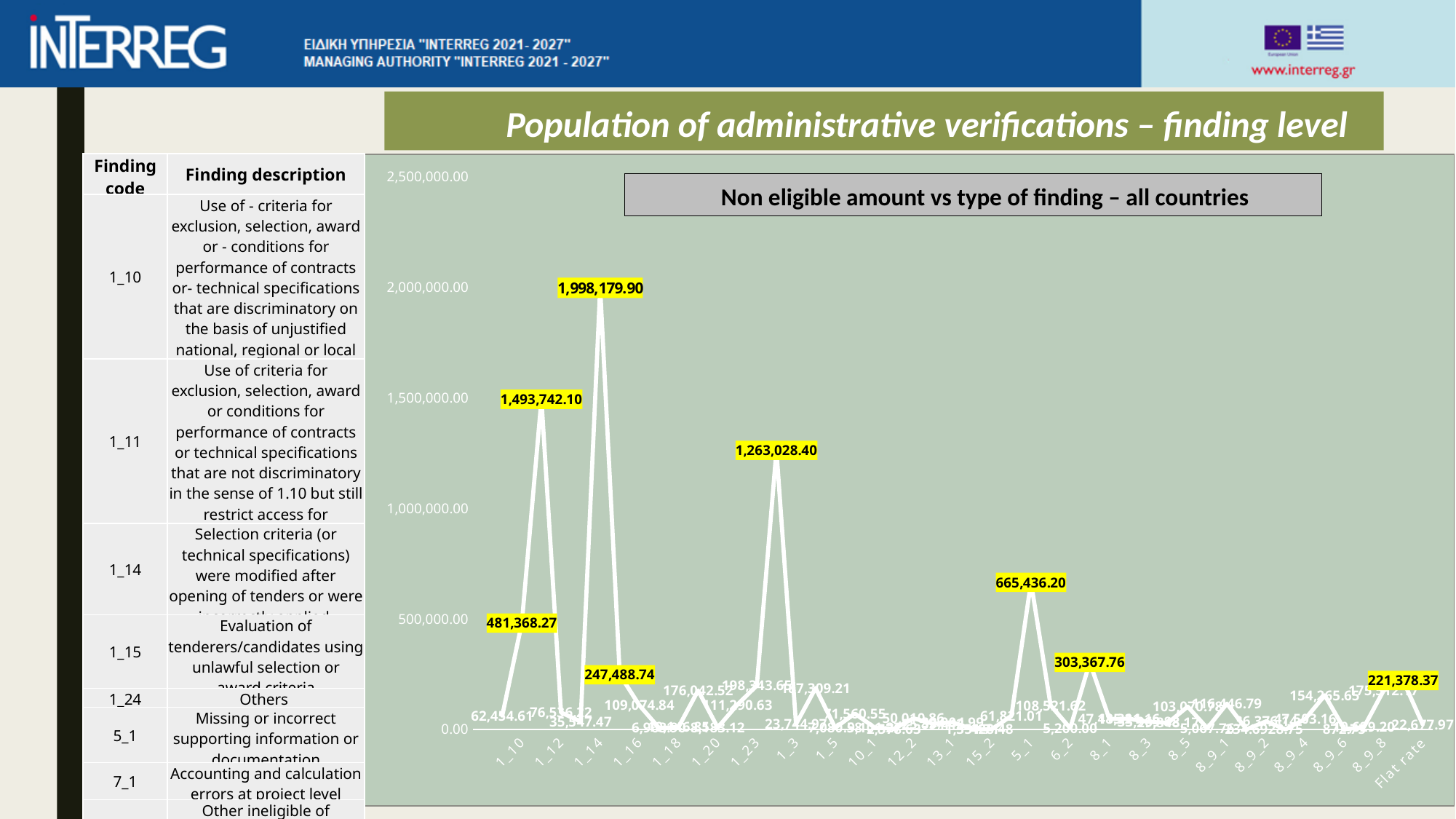
Which is larger, the highlighted value 665,436.20 or the highlighted value 303,367.76? 665,436.20 What is the difference between the two highest highlighted values, 1,998,179.90 and 1,493,742.10? 504,437.80 What is the highest value labelled on the chart? 1,998,179.90 What is the second-highest value highlighted on the chart? 1,493,742.10 How many data points are highlighted with yellow labels on the chart? 8 What is the highest tick value shown on the y axis? 2,500,000.00 What is the value of the last highlighted point on the right of the chart? 221,378.37 Is the highest point on the chart greater or less than 1,500,000.00? greater Is the first plotted point (481,368.27) greater or less than 500,000.00? less What is the title of the chart? Non eligible amount vs type of finding – all countries What is the difference between the highlighted values 1,263,028.40 and 665,436.20? 597,592.20 What kind of chart is shown on the slide? line chart